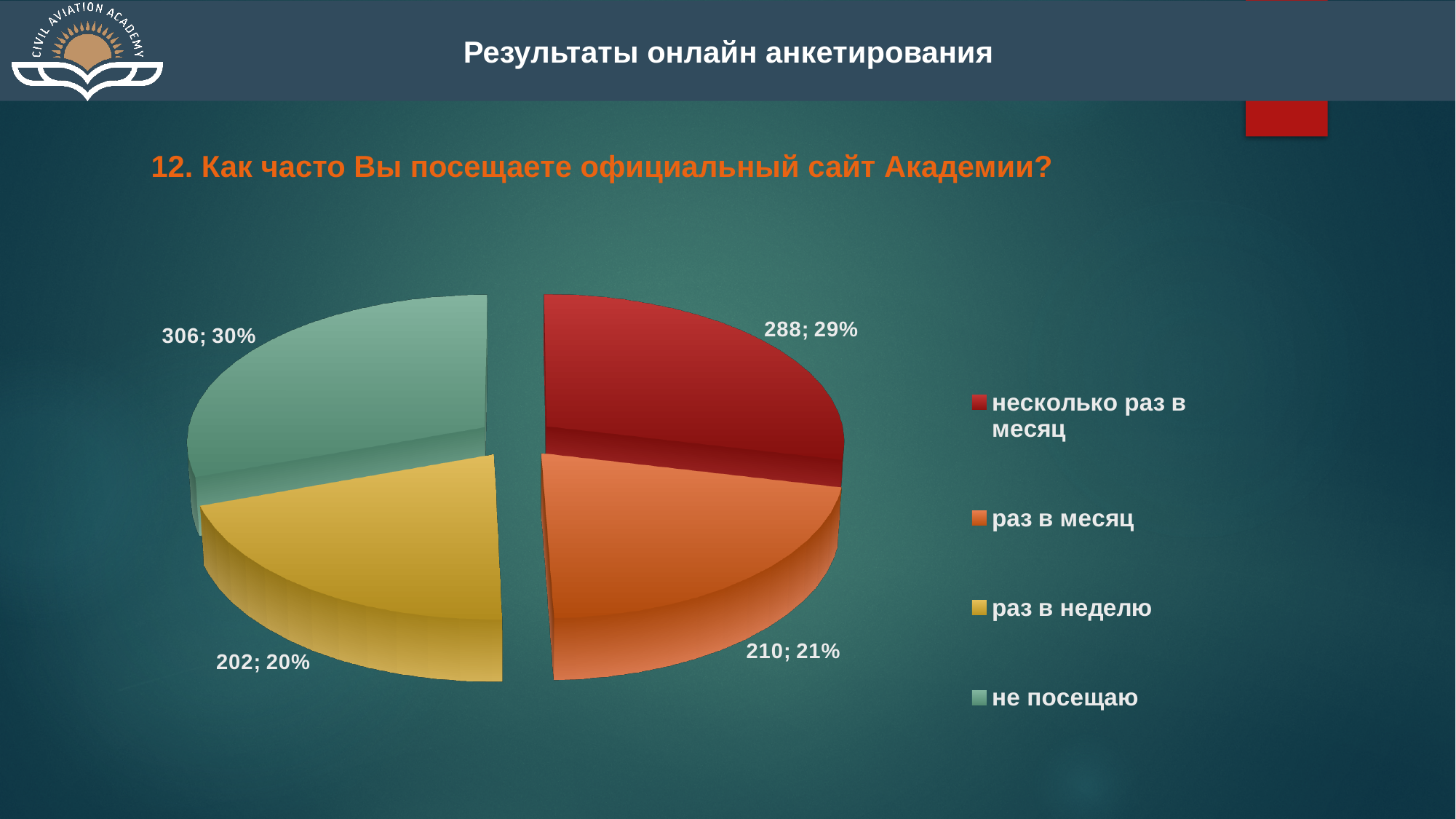
What is the value shown for "не посещаю"? 306; 30% What is the value shown for "несколько раз в месяц"? 288; 29% What kind of chart is shown on the slide? pie chart How many entries does the legend list? 4 How many slices does the pie chart have? 4 What share of the pie does "раз в месяц" represent? 21% Which category has the smallest slice? раз в неделю Which category has the largest slice? не посещаю Which is larger, the count for "раз в месяц" or for "раз в неделю"? раз в месяц What is the value shown for "раз в неделю"? 202; 20% What is the difference between the counts for "не посещаю" and "несколько раз в месяц"? 18 What colour is the slice for "раз в неделю"? yellow